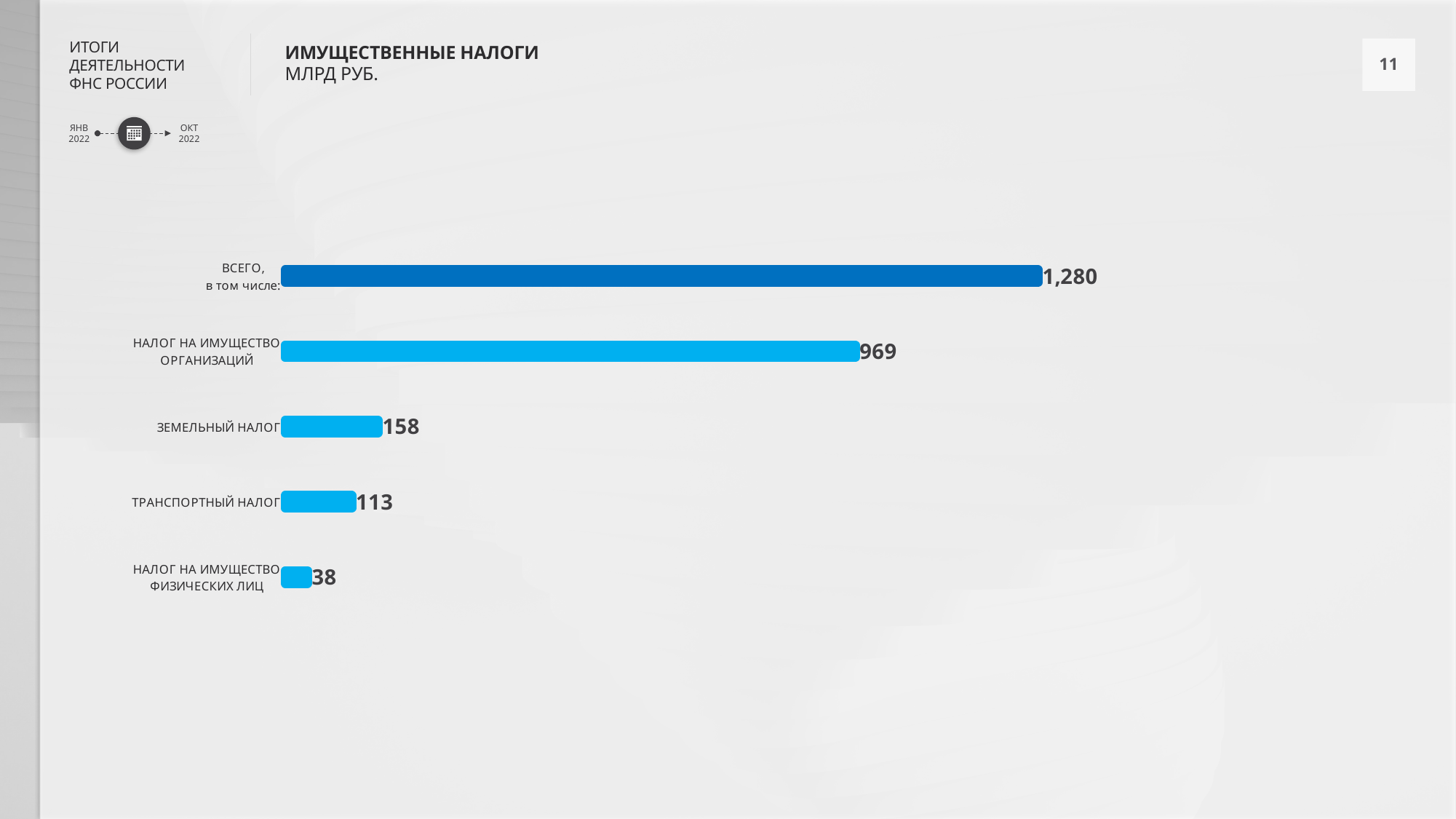
What is the difference between ЗЕМЕЛЬНЫЙ НАЛОГ and ТРАНСПОРТНЫЙ НАЛОГ? 45 What kind of chart is shown on the slide? Bar chart What is the value for ВСЕГО, в том числе? 1,280 What is the value for НАЛОГ НА ИМУЩЕСТВО ОРГАНИЗАЦИЙ? 969 Which is larger, ЗЕМЕЛЬНЫЙ НАЛОГ or ТРАНСПОРТНЫЙ НАЛОГ? ЗЕМЕЛЬНЫЙ НАЛОГ What is the value for НАЛОГ НА ИМУЩЕСТВО ФИЗИЧЕСКИХ ЛИЦ? 38 Which category has the lowest value? НАЛОГ НА ИМУЩЕСТВО ФИЗИЧЕСКИХ ЛИЦ What is the value for ЗЕМЕЛЬНЫЙ НАЛОГ? 158 What is the difference between ВСЕГО and НАЛОГ НА ИМУЩЕСТВО ОРГАНИЗАЦИЙ? 311 Excluding the total bar, which category has the highest value? НАЛОГ НА ИМУЩЕСТВО ОРГАНИЗАЦИЙ What is the value for ТРАНСПОРТНЫЙ НАЛОГ? 113 How many bars are shown in the chart? 5